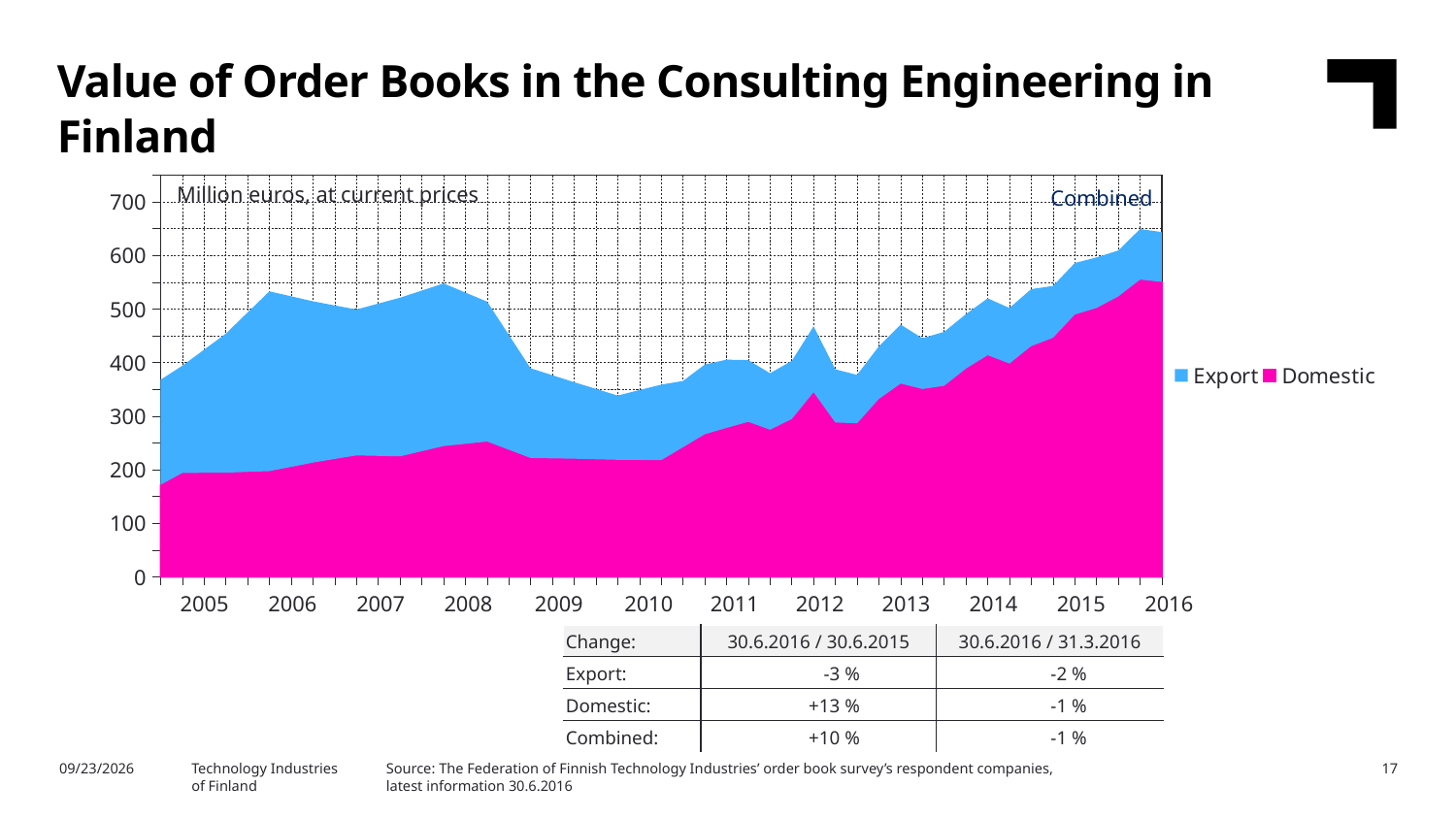
Is the combined value in 2010 greater or less than 400? less According to the table below the chart, what is the change in Domestic order books for 30.6.2016 / 30.6.2015? +13 % Is the Domestic value in 2016 greater or less than 500? greater How many series does the chart legend list? 2 How many years are labelled on the x axis of the chart? 12 In 2016, which is larger, the Export portion or the Domestic portion? Domestic Is the combined value of order books in 2016 greater or less than 600? greater What unit is stated in the chart's subtitle? Million euros, at current prices Which two series are listed in the chart legend? Export and Domestic What kind of chart is shown on the slide? Stacked area chart Does the Domestic value rise or fall between 2010 and 2016? Rise In which year shown on the x axis is the combined value of order books highest? 2016